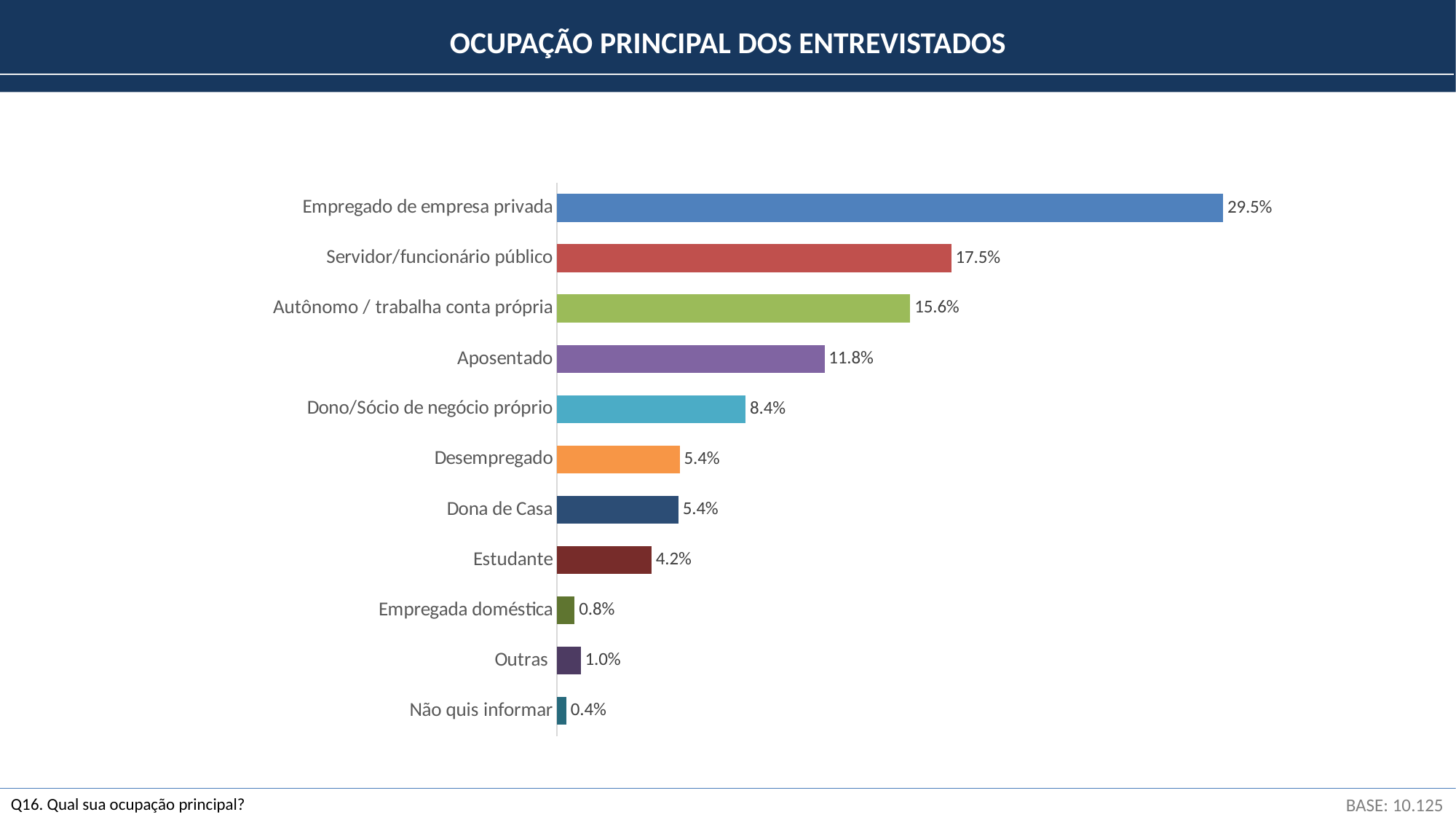
What is the value for Estudante? 4.2% Which category has the lowest value? Não quis informar Which is larger, Dono/Sócio de negócio próprio or Estudante? Dono/Sócio de negócio próprio What is the difference between Empregado de empresa privada and Aposentado? 17.7% What is the value for Não quis informar? 0.4% What is the difference between Servidor/funcionário público and Autônomo / trabalha conta própria? 1.9% Which category has the highest value? Empregado de empresa privada What is the value for Empregado de empresa privada? 29.5% What is the title of the slide? OCUPAÇÃO PRINCIPAL DOS ENTREVISTADOS What is the value for Aposentado? 11.8% What kind of chart is shown on the slide? Bar chart How many categories are shown in the chart? 11